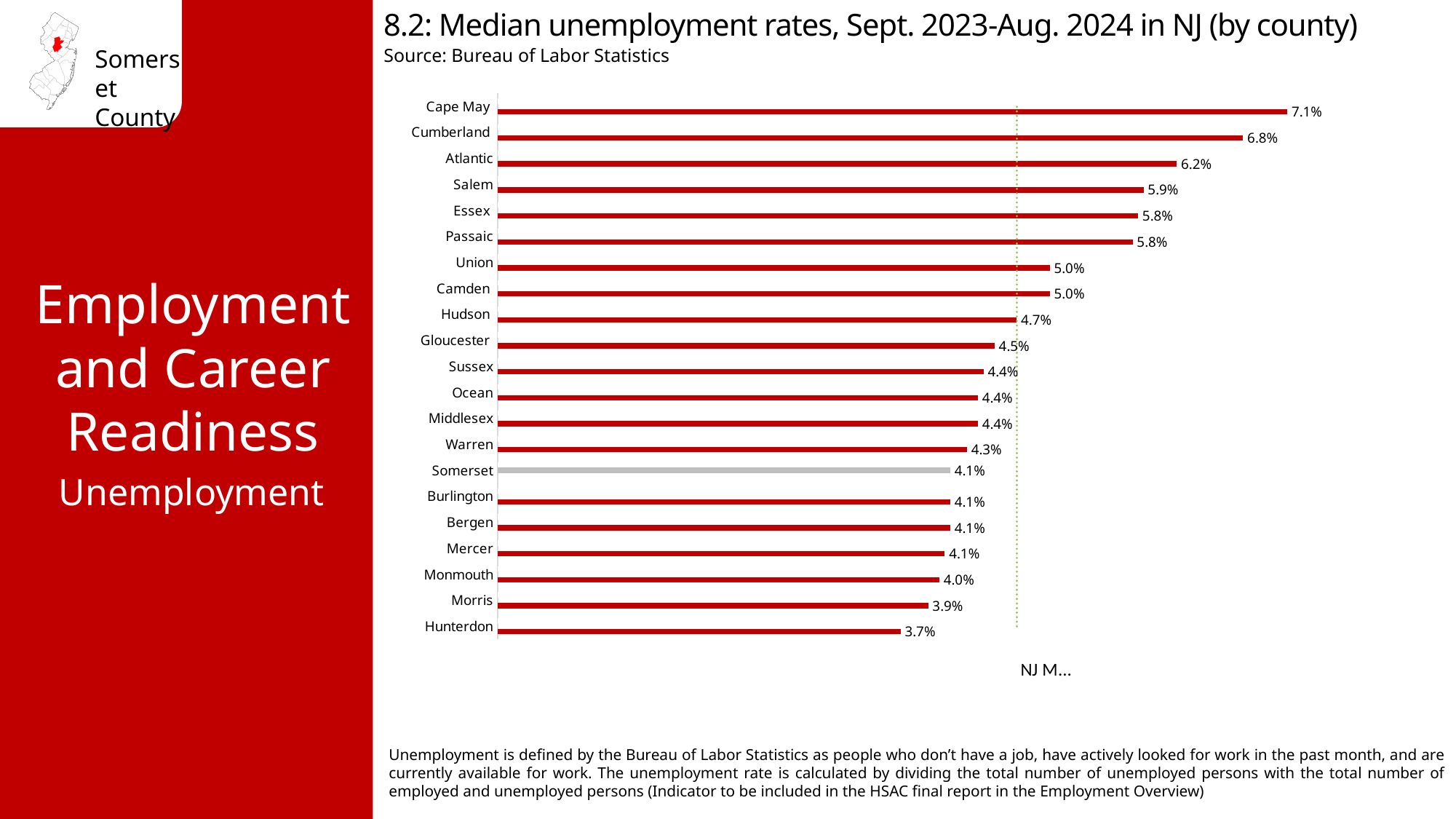
Which county has the highest median unemployment rate? Cape May How many counties are shown in the chart? 21 What kind of chart is used to show the median unemployment rates? Bar chart Which county's bar is shown in grey instead of red? Somerset Which county has a higher median unemployment rate, Atlantic or Salem? Atlantic What is the median unemployment rate for Somerset? 4.1% Which county has a higher median unemployment rate, Morris or Monmouth? Monmouth What is the median unemployment rate for Cape May? 7.1% What is the median unemployment rate for Hudson? 4.7% Which county has the lowest median unemployment rate? Hunterdon What is the difference between the median unemployment rates of Cape May and Hunterdon? 3.4% What is the difference between the median unemployment rates of Cumberland and Somerset? 2.7%